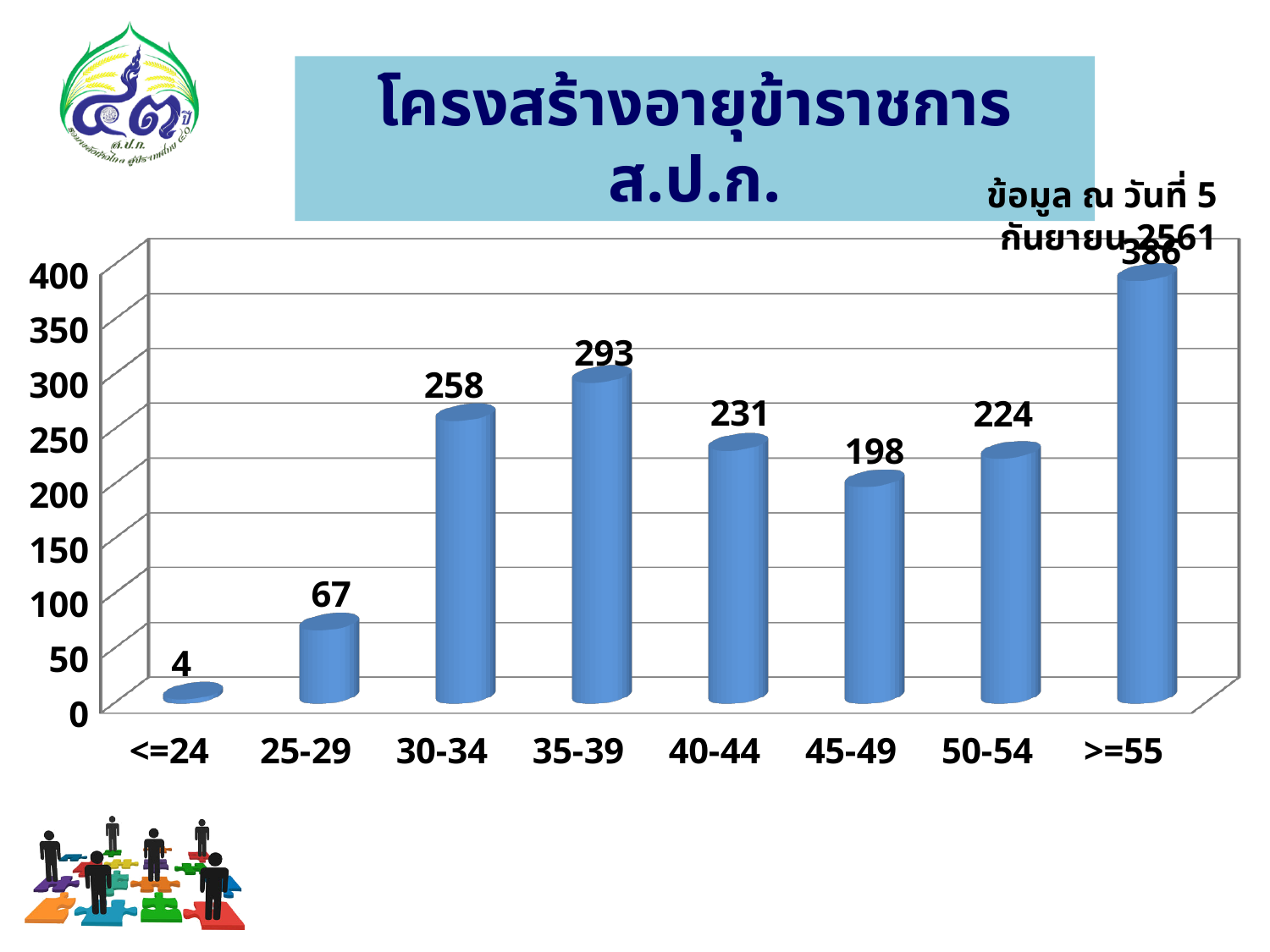
What is the value for the 45-49 age group? 198 What is the difference between the values for 30-34 and 40-44? 27 What is the value for the 25-29 age group? 67 What is the value for the <=24 age group? 4 What type of chart is shown on the slide? bar chart Which is larger, the value for 50-54 or the value for 45-49? 50-54 What colour are the bars in the chart? blue Is the value for the 40-44 age group greater or less than 250? less What is the value for the 35-39 age group? 293 Which age group has the lowest value? <=24 Which age group has the highest value? >=55 How many age-group categories are shown on the x axis? 8